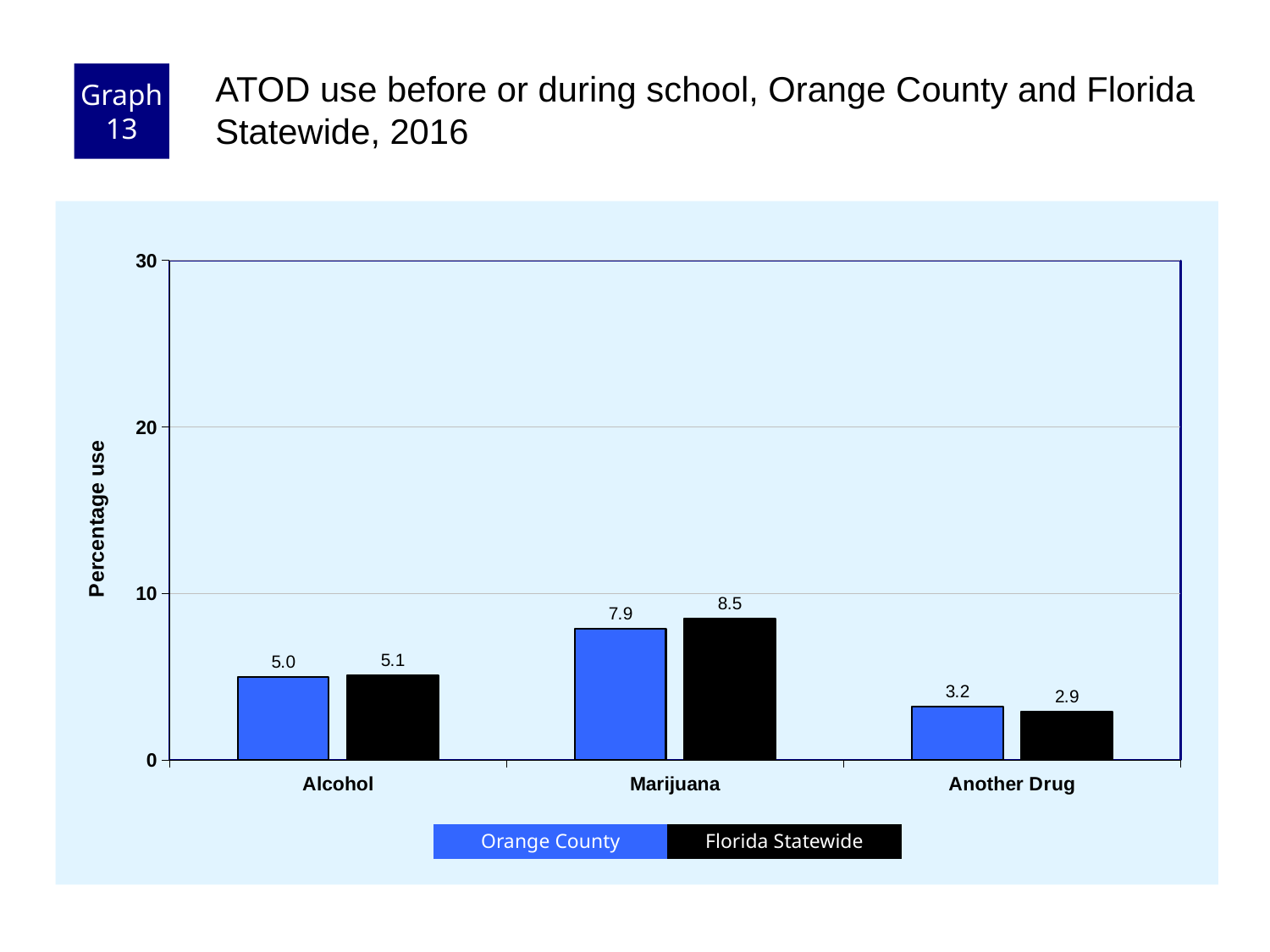
What is the Orange County value for Marijuana? 7.9 What is the difference between the Florida Statewide and Orange County values for Marijuana? 0.6 For Another Drug, which is larger: the Orange County value or the Florida Statewide value? Orange County What is the Florida Statewide value for Alcohol? 5.1 What kind of chart is shown on the slide? bar chart Which category has the highest Florida Statewide value? Marijuana How many series does the legend list? 2 What is the Orange County value for Another Drug? 3.2 Which category has the lowest Orange County value? Another Drug Is the Florida Statewide value for Marijuana greater or less than 10? less How many categories are shown on the x axis? 3 What is the Florida Statewide value for Another Drug? 2.9